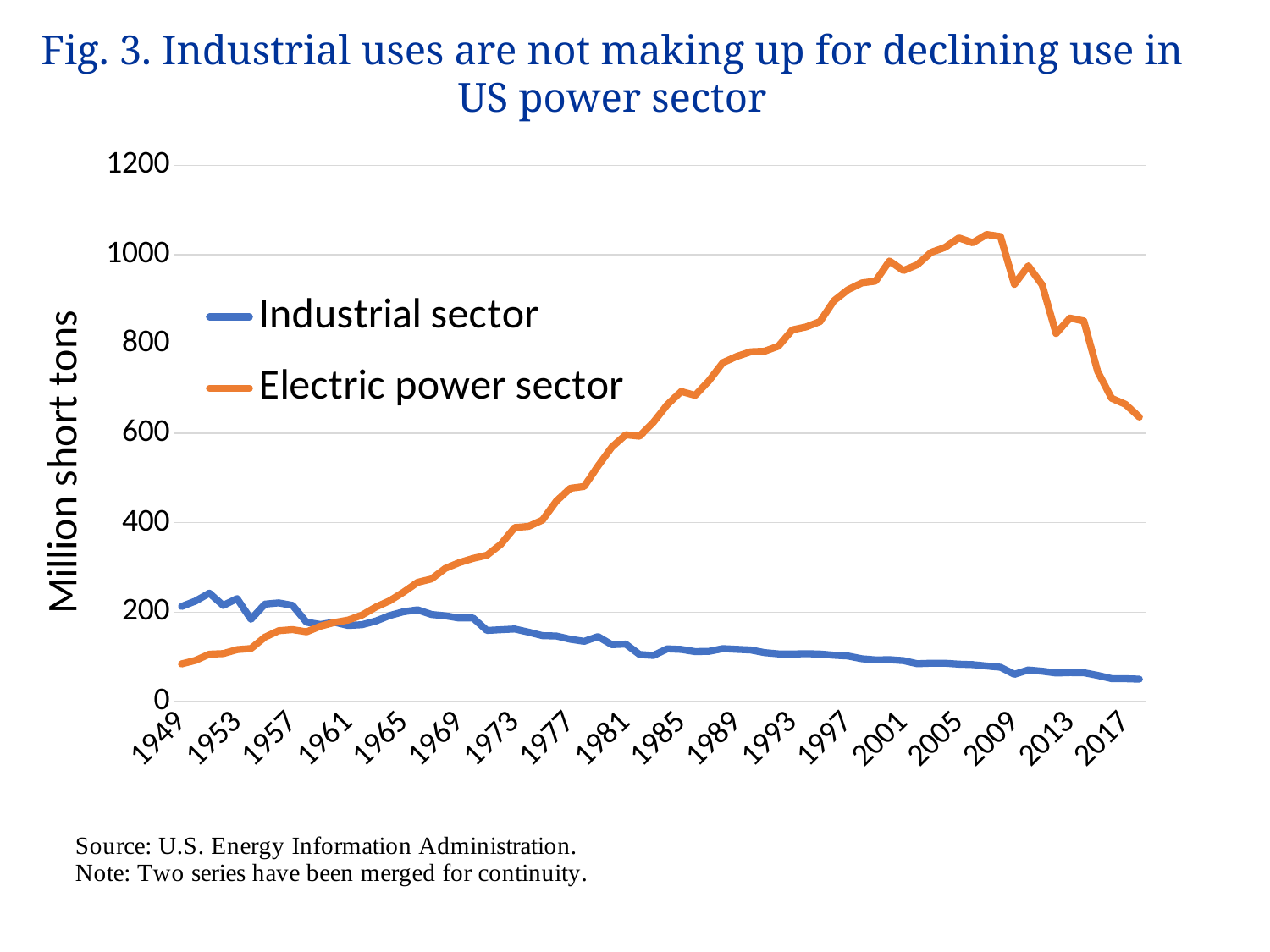
What is the label on the vertical axis? Million short tons Which two series are shown in the legend? Industrial sector and Electric power sector Is the value for the Industrial sector in 2017 greater or less than 100? less Which series has the larger value in 2009, Industrial sector or Electric power sector? Electric power sector Which series has the larger value in 1949, Industrial sector or Electric power sector? Industrial sector Is the value for the Electric power sector in 1985 greater or less than 600? greater How many series does the legend list? 2 Does the Electric power sector line rise or fall between 1949 and 2005? rise Does the Industrial sector line rise or fall between 1969 and 2017? fall Is the value for the Electric power sector in 1977 greater or less than 400? greater What kind of chart is shown on the slide? Line chart